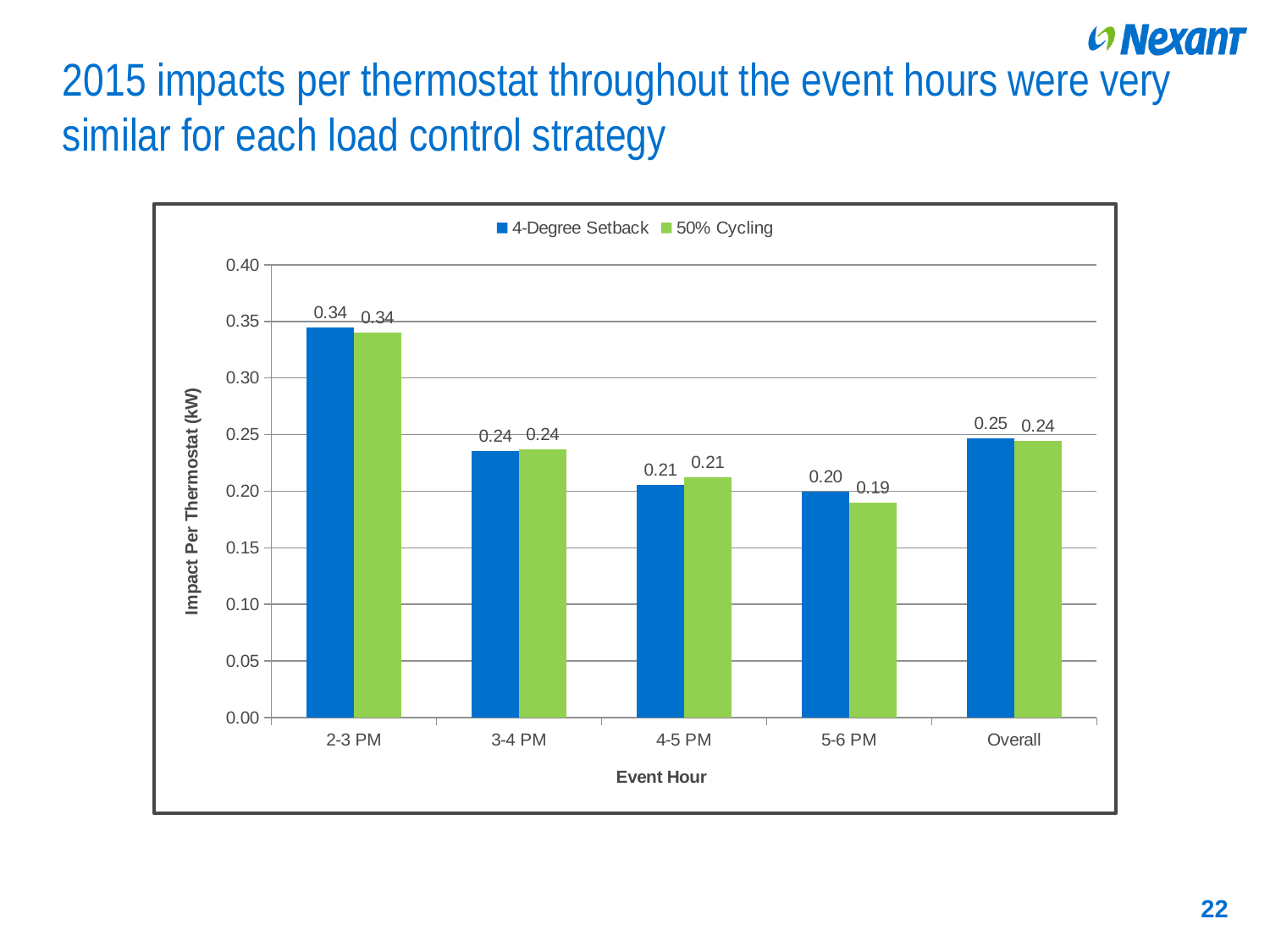
What is the impact per thermostat for 4-Degree Setback in the 2-3 PM hour? 0.34 Is the 4-Degree Setback impact at 3-4 PM greater or less than 0.30? less How many series does the legend list? 2 What is the label of the y axis? Impact Per Thermostat (kW) Which event hour has the highest impact per thermostat for 4-Degree Setback? 2-3 PM How many event hour categories are shown on the x axis? 5 What kind of chart is shown on the slide? bar chart Which event hour has the lowest impact per thermostat for 50% Cycling? 5-6 PM What is the Overall impact per thermostat for 4-Degree Setback? 0.25 What is the impact per thermostat for 50% Cycling in the 4-5 PM hour? 0.21 What is the impact per thermostat for 50% Cycling in the 5-6 PM hour? 0.19 What is the difference between the 4-Degree Setback impact at 2-3 PM and at 5-6 PM? 0.14